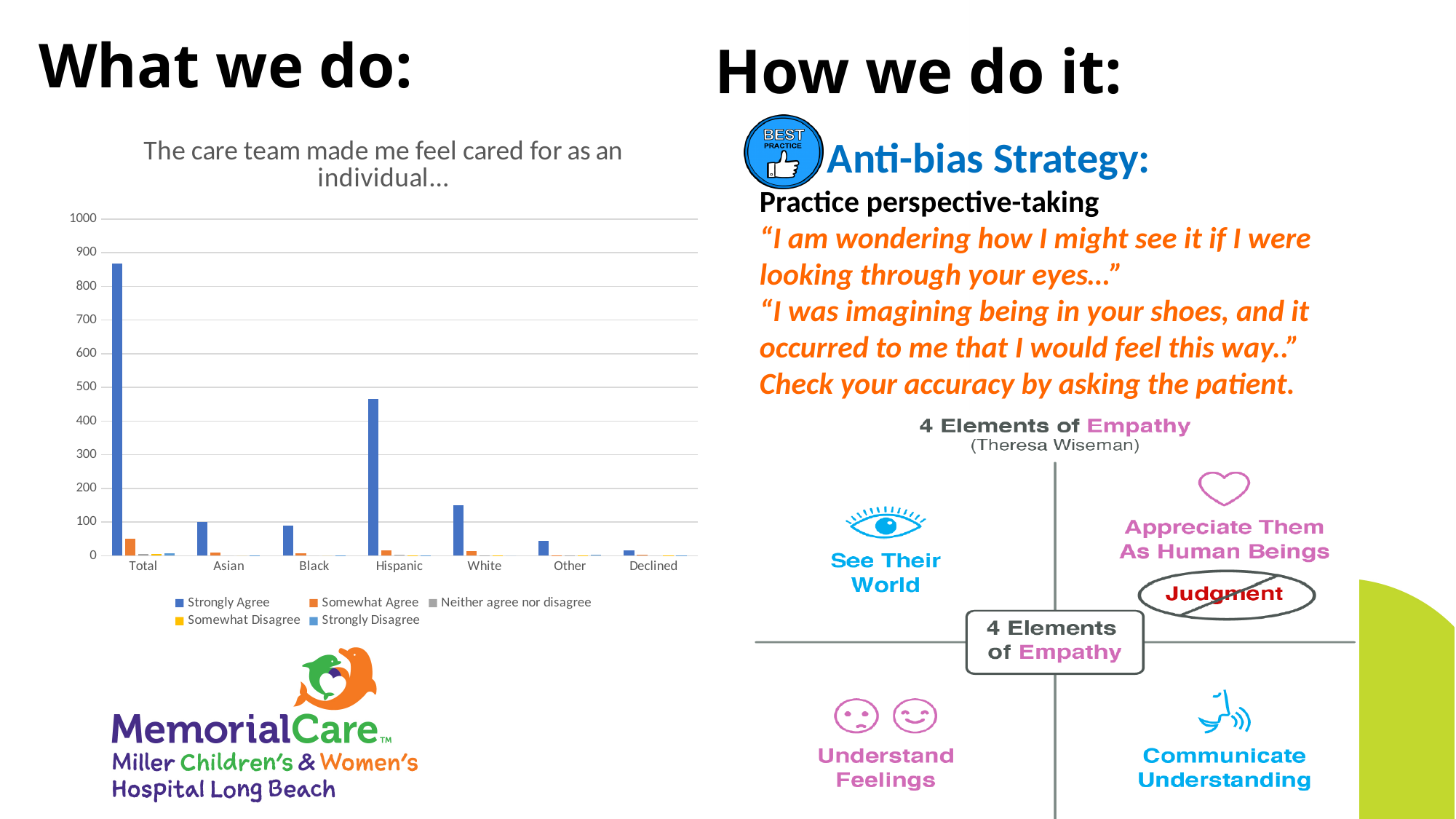
How many categories are shown on the x axis of the chart? 7 Which category has the highest Strongly Agree value? Total Which category has the lowest Strongly Agree value? Declined Is the Strongly Agree value for White greater or less than 100? greater What type of chart is shown on the slide? bar chart Which is larger, the Strongly Agree value for Hispanic or for White? Hispanic Excluding Total, which category has the highest Strongly Agree value? Hispanic How many series does the chart's legend list? 5 Is the Strongly Agree value for Hispanic greater or less than 500? less What is the title of the chart? The care team made me feel cared for as an individual... Which colour represents the Somewhat Agree series in the chart? orange Is the Strongly Agree value for Total greater or less than 800? greater